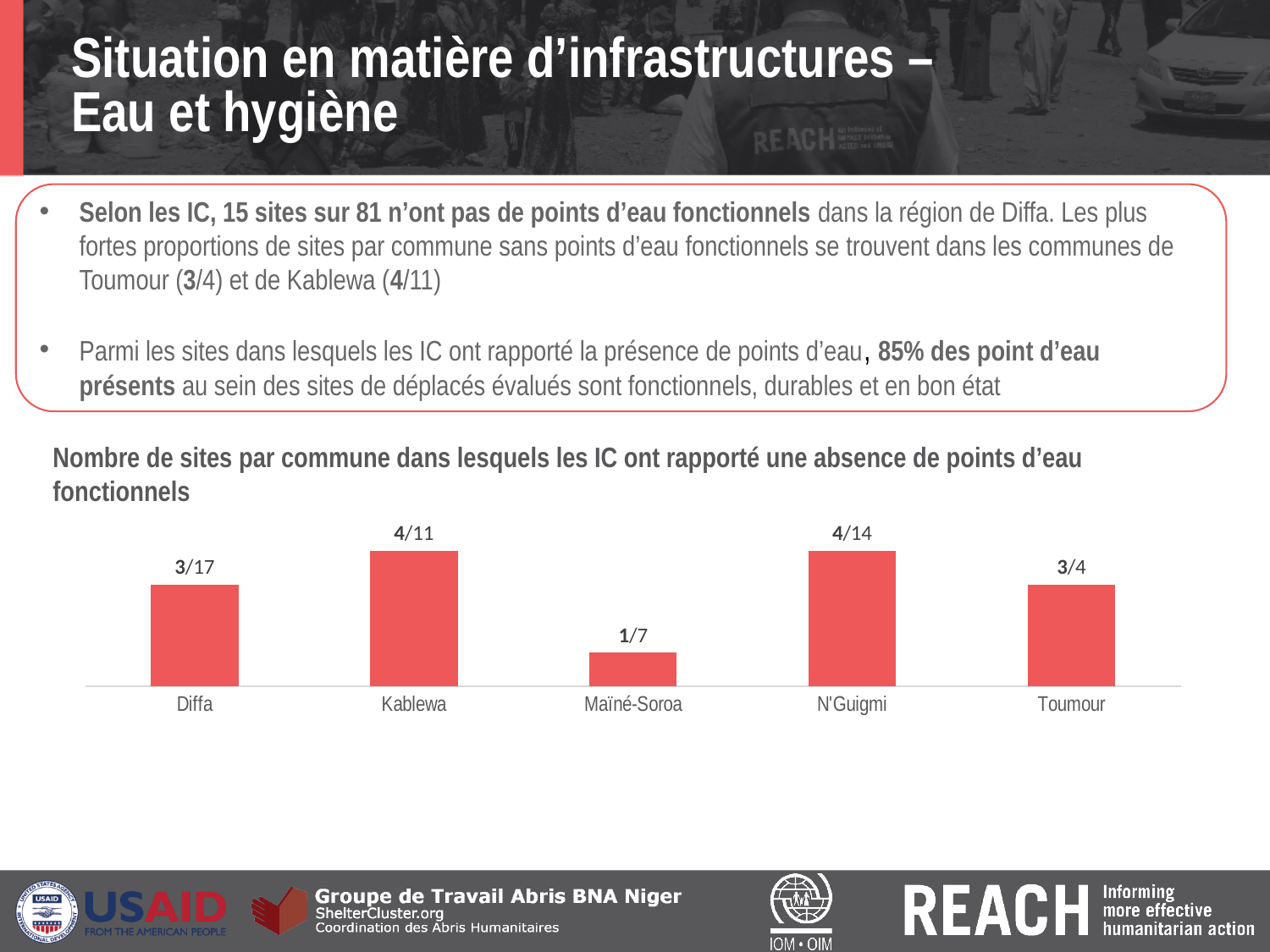
What label is shown above the bar for Kablewa? 4/11 Which commune has more sites without functional water points, Kablewa or Diffa? Kablewa What label is shown above the bar for N'Guigmi? 4/14 What kind of chart is used on the slide? Bar chart What label is shown above the bar for Toumour? 3/4 How many more sites without functional water points does Kablewa have than Maïné-Soroa? 3 Which commune has the lowest number of sites without functional water points? Maïné-Soroa How many communes are shown on the x axis of the chart? 5 Which commune has more sites without functional water points, Toumour or Maïné-Soroa? Toumour What label is shown above the bar for Diffa? 3/17 What is the title of the chart? Nombre de sites par commune dans lesquels les IC ont rapporté une absence de points d'eau fonctionnels What label is shown above the bar for Maïné-Soroa? 1/7